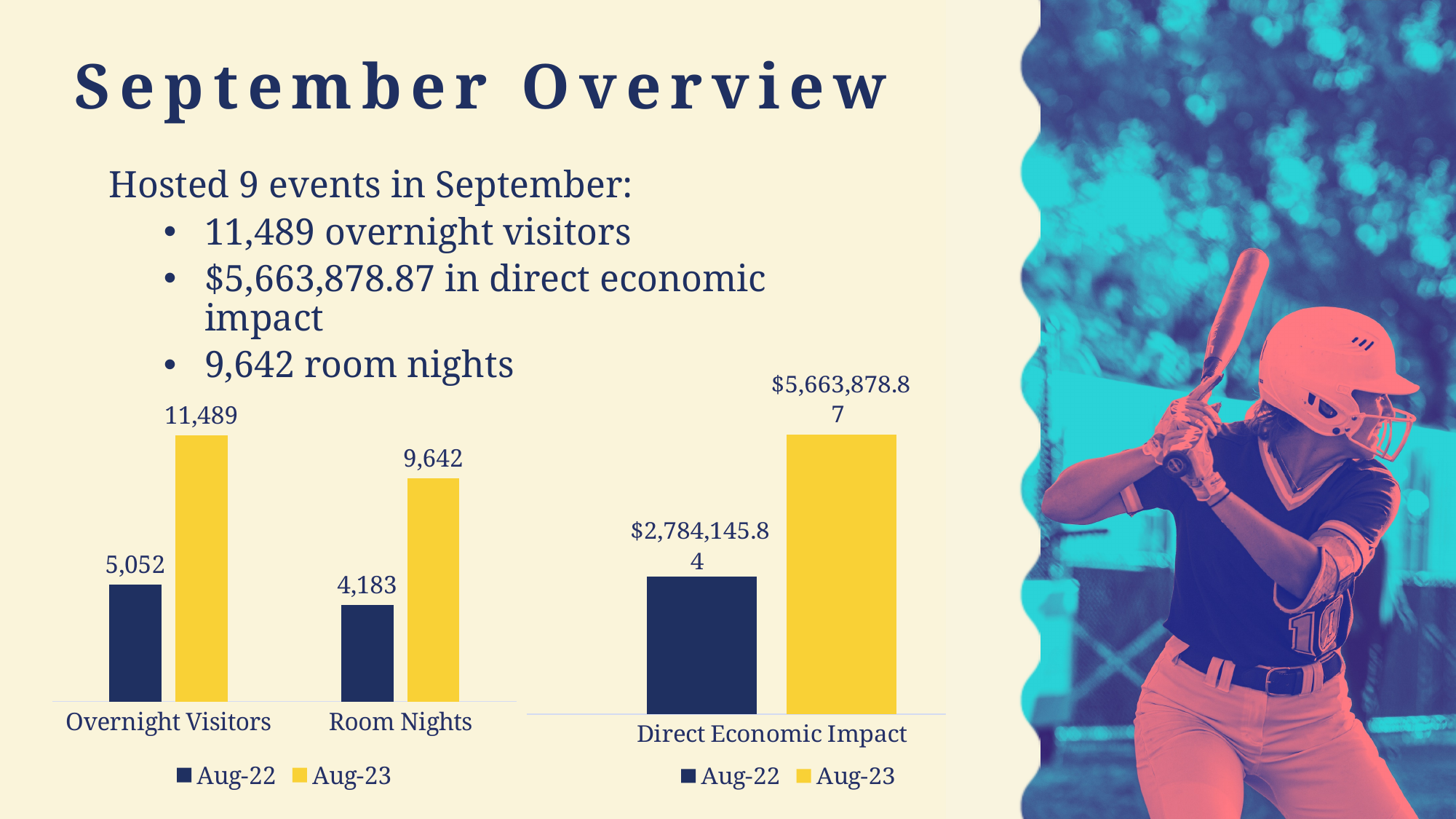
In the left chart, which bar is the highest? Overnight Visitors, Aug-23 What type of chart is the left chart? Bar chart In the left chart, what is the difference between the Aug-23 and Aug-22 values for Room Nights? 5,459 In the left chart, what is the Aug-23 value for Overnight Visitors? 11,489 In the left chart, how many categories are shown on the x axis? 2 In the left chart, which is larger: the Aug-22 value for Overnight Visitors or the Aug-22 value for Room Nights? Overnight Visitors In the left chart, what is the difference between the Aug-23 and Aug-22 values for Overnight Visitors? 6,437 In the left chart, what is the Aug-22 value for Room Nights? 4,183 In the right chart, what is the Aug-23 value for Direct Economic Impact? $5,663,878.87 In the right chart, what is the Aug-22 value for Direct Economic Impact? $2,784,145.84 In the right chart, by how much does the Aug-23 Direct Economic Impact exceed the Aug-22 value? $2,879,733.03 In the right chart, how many series does the legend list? 2